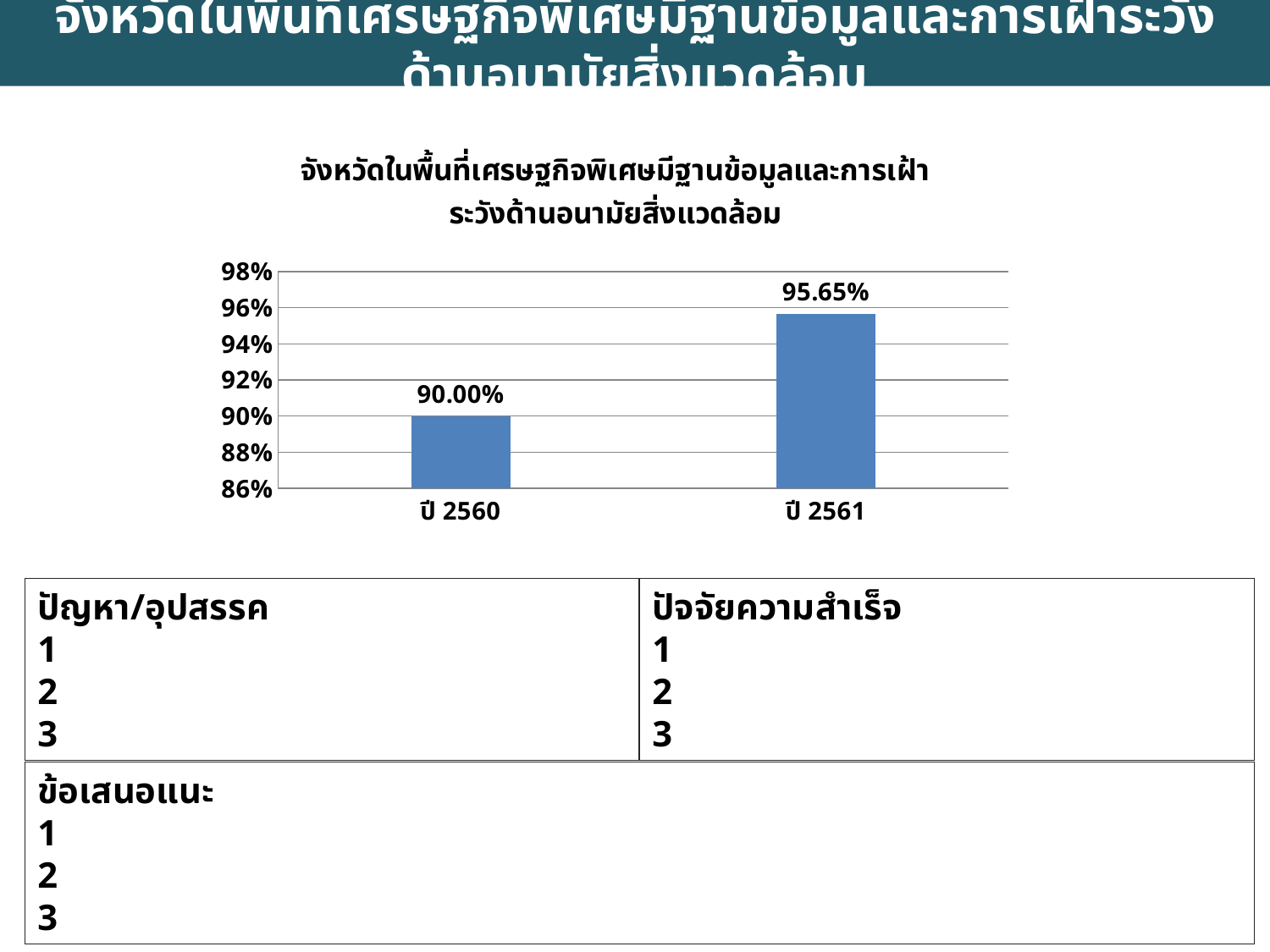
Is the value for ปี 2560 greater or less than 92%? less Is the value for ปี 2561 greater or less than 94%? greater What kind of chart is shown on the slide? bar chart What is the lowest value shown on the y axis? 86% Which category has the lowest value? ปี 2560 What is the value for ปี 2561? 95.65% How many categories are shown on the x axis? 2 What is the difference between the values for ปี 2561 and ปี 2560? 5.65% Which category has the highest value? ปี 2561 Which is larger, the value for ปี 2560 or ปี 2561? ปี 2561 Do the values rise or fall from ปี 2560 to ปี 2561? rise What is the value for ปี 2560? 90.00%